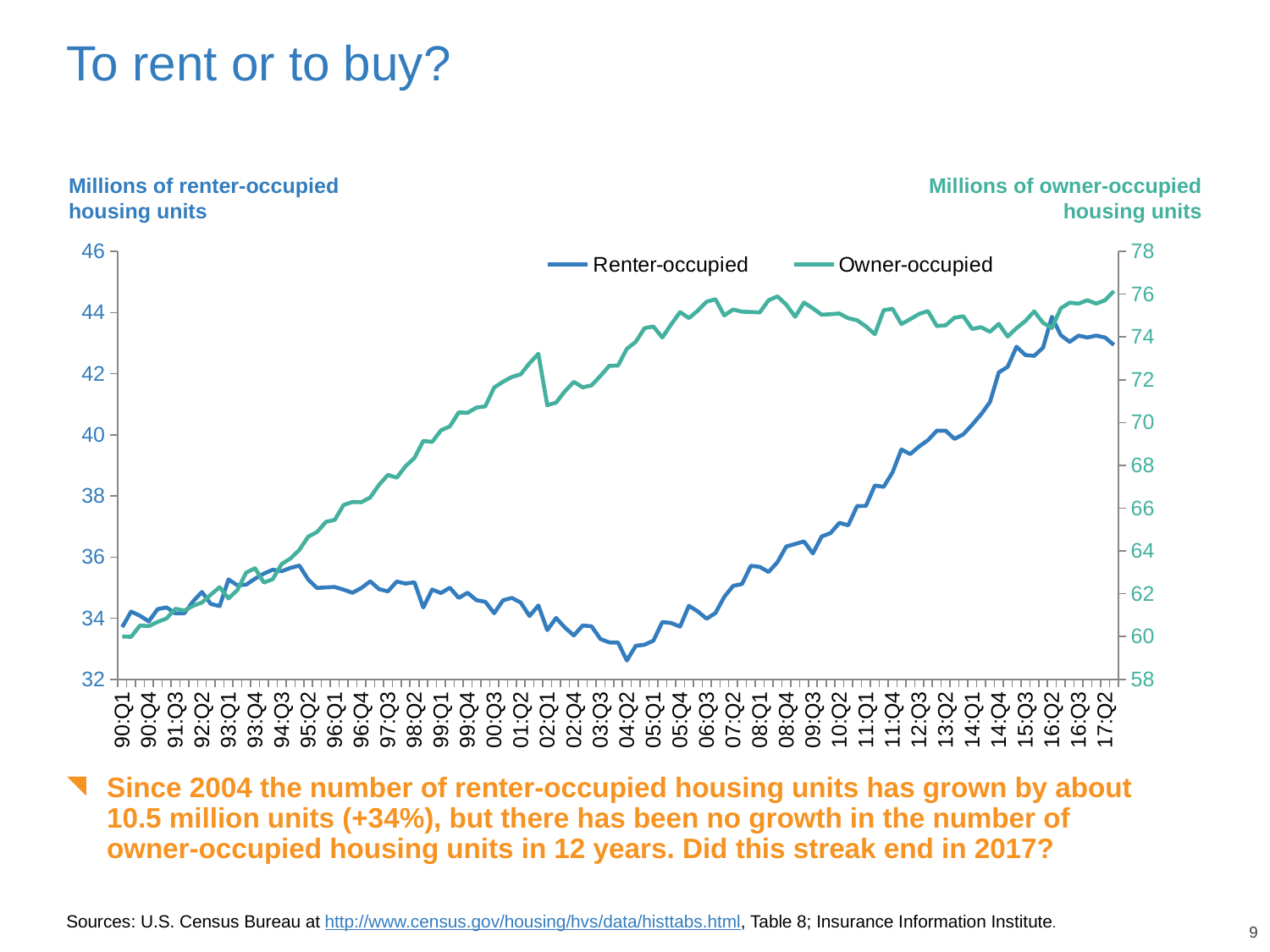
Does the Owner-occupied line rise or fall from 90:Q1 to 06:Q3? rise Is the value for Renter-occupied at 17:Q2 greater or less than 42? greater Does the Renter-occupied line rise or fall from 04:Q2 to 17:Q2? rise Is the value for Owner-occupied at 17:Q2 greater or less than 74? greater How many series does the legend list? 2 What is the label of the left vertical axis? Millions of renter-occupied housing units Is the value for Owner-occupied at 90:Q1 greater or less than 62? less In which year does the Renter-occupied line reach its lowest point? 2004 What kind of chart is shown on the slide? Line chart